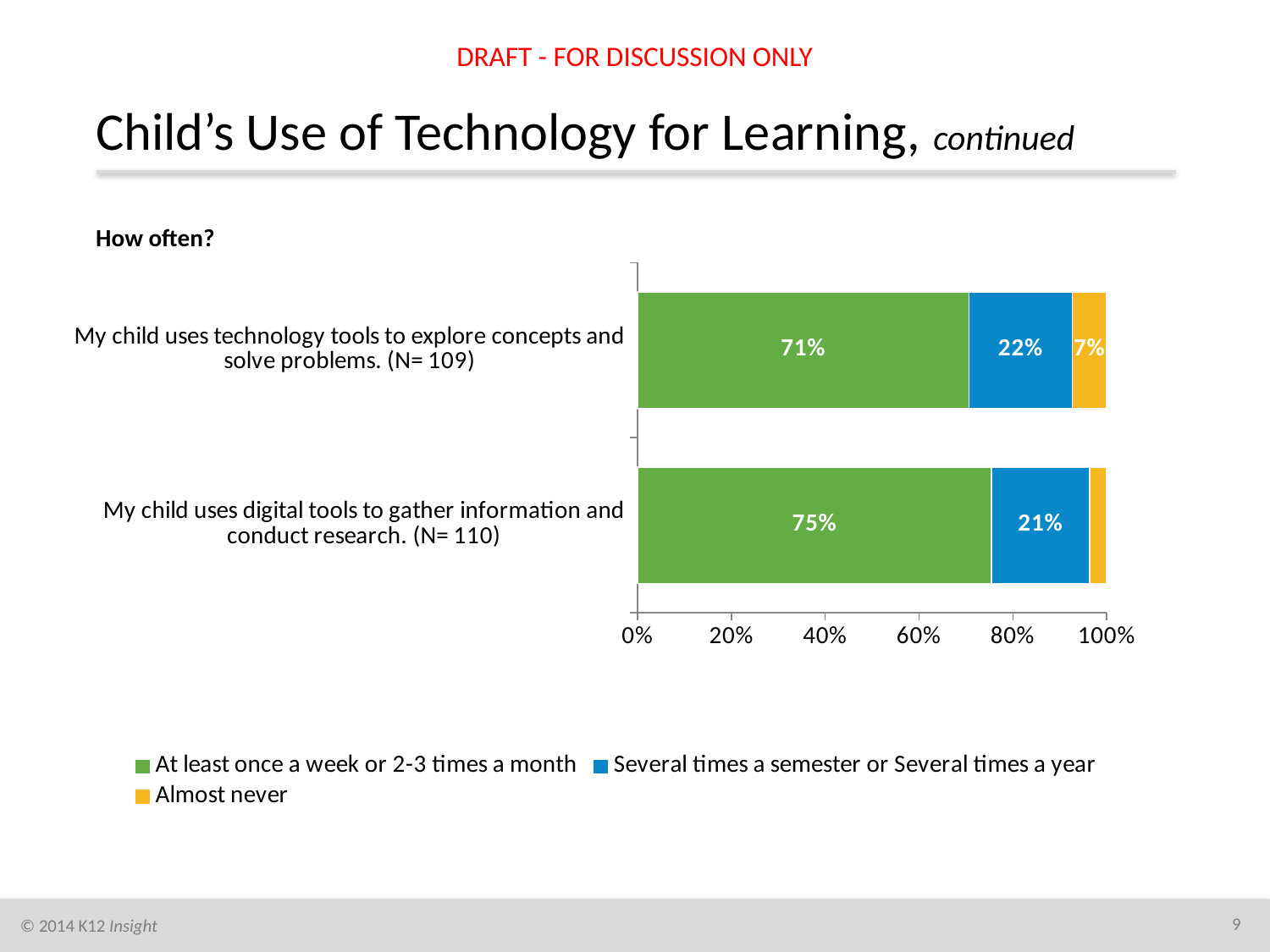
How many statements (bars) are shown in the chart? 2 What is the total of the labelled segments for 'My child uses technology tools to explore concepts and solve problems'? 100% What is the 'Almost never' value for 'My child uses technology tools to explore concepts and solve problems'? 7% How many series does the legend list? 3 What percentage of respondents said their child uses technology tools to explore concepts and solve problems at least once a week or 2-3 times a month? 71% What is the 'Several times a semester or Several times a year' value for 'My child uses technology tools to explore concepts and solve problems'? 22% What percentage of respondents said their child uses digital tools to gather information and conduct research at least once a week or 2-3 times a month? 75% What is the 'Several times a semester or Several times a year' value for 'My child uses digital tools to gather information and conduct research'? 21% Is the 'Almost never' value for 'My child uses digital tools to gather information and conduct research' greater or less than 20%? less What type of chart is shown on the slide? Stacked bar chart Which statement has the higher 'At least once a week or 2-3 times a month' percentage? My child uses digital tools to gather information and conduct research. What is the difference in percentage points between the 'At least once a week or 2-3 times a month' values for the two statements? 4 percentage points